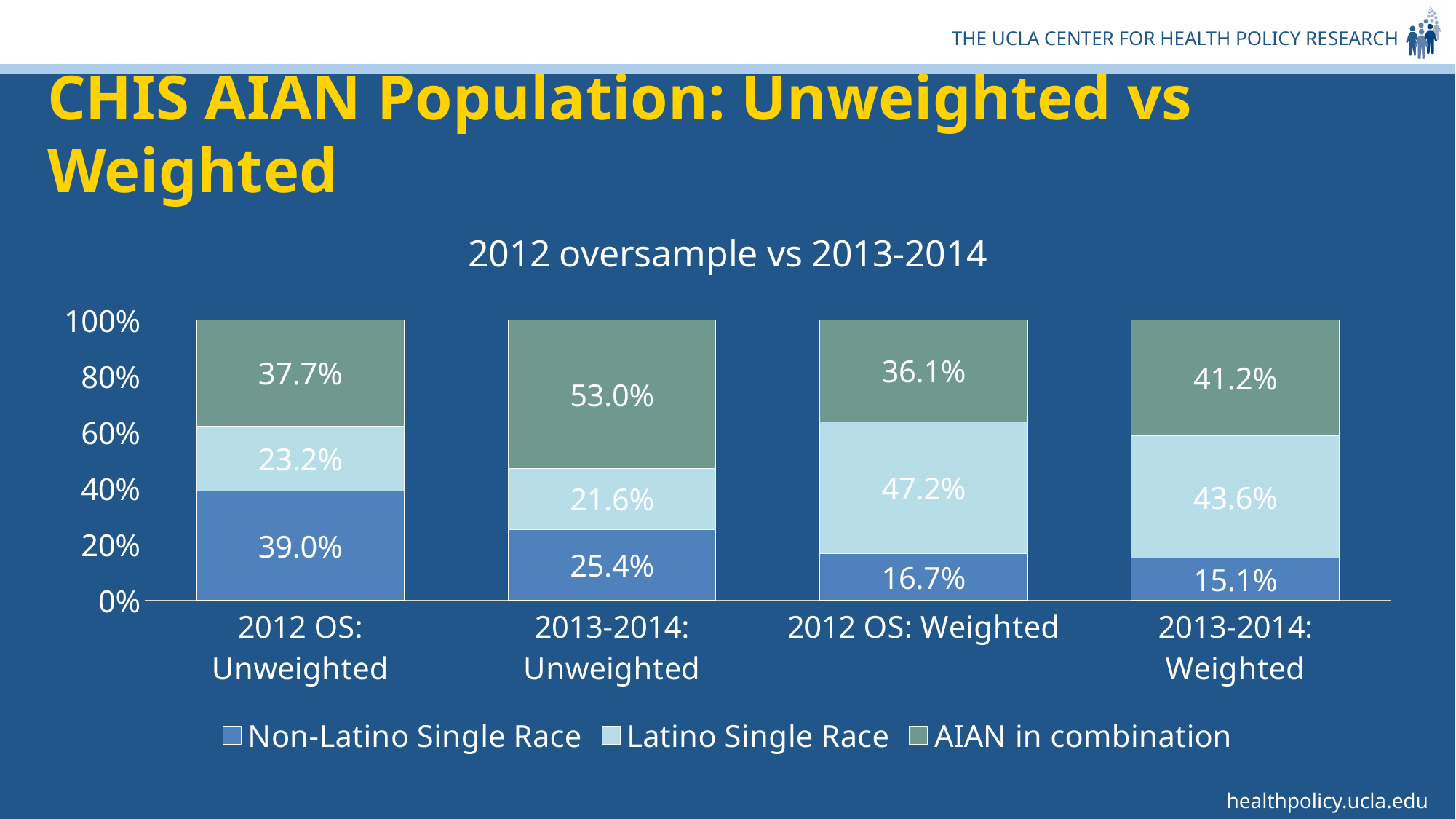
Which category has the lowest value for Non-Latino Single Race? 2013-2014: Weighted What is the difference between the Latino Single Race values for 2012 OS: Weighted and 2012 OS: Unweighted? 24.0% What is the value for Non-Latino Single Race in the 2012 OS: Unweighted bar? 39.0% What is the value for AIAN in combination in the 2013-2014: Unweighted bar? 53.0% What is the value for Latino Single Race in the 2012 OS: Weighted bar? 47.2% How many categories are shown on the x axis? 4 Which is larger: the AIAN in combination value for 2012 OS: Unweighted or for 2013-2014: Weighted? 2013-2014: Weighted Which category has the highest value for AIAN in combination? 2013-2014: Unweighted What is the value for Non-Latino Single Race in the 2013-2014: Weighted bar? 15.1% What kind of chart is shown on the slide? Stacked bar chart How many series does the legend list? 3 What is the title of the chart? 2012 oversample vs 2013-2014